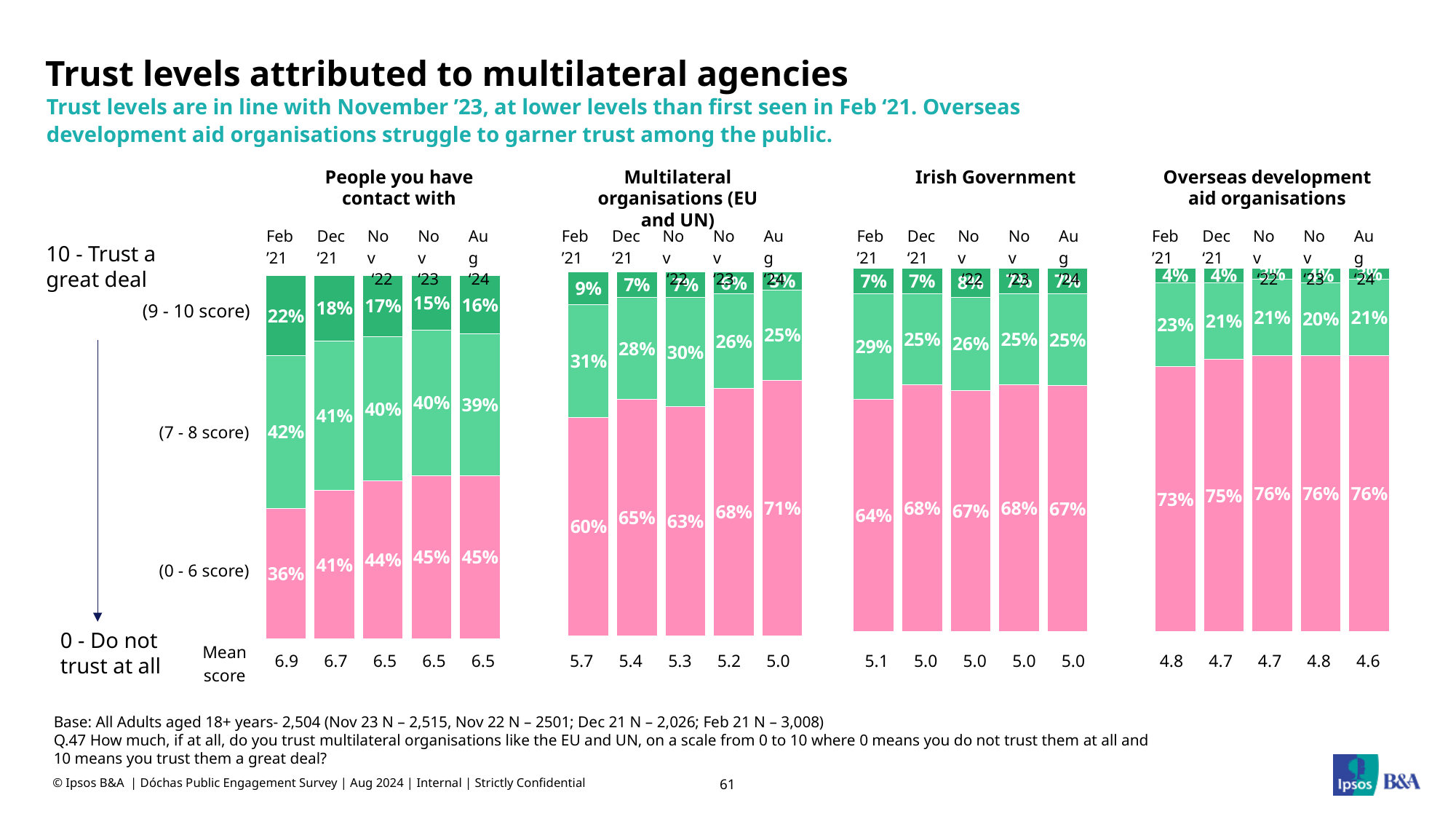
In the 'Overseas development aid organisations' chart, is the 0-6 score percentage larger in Feb '21 or in Dec '21? Dec '21 In the 'Overseas development aid organisations' chart, what is the mean score for Aug '24? 4.6 In the 'People you have contact with' chart, what percentage gave a 0-6 score in Feb '21? 36% In the 'People you have contact with' chart, which wave has the highest mean score? Feb '21 In the 'People you have contact with' chart, what is the difference between the 0-6 score percentage in Aug '24 and in Feb '21? 9 percentage points What type of chart is used on this slide? Stacked bar chart In the 'Multilateral organisations (EU and UN)' chart, what percentage gave a 9-10 score in Feb '21? 9% In the 'Multilateral organisations (EU and UN)' chart, what percentage gave a 0-6 score in Aug '24? 71% How many waves (bars) are shown in the 'Irish Government' chart? 5 In the 'Irish Government' chart, what percentage gave a 7-8 score in Feb '21? 29% In the 'Multilateral organisations (EU and UN)' chart, which wave has the lowest mean score? Aug '24 In the 'People you have contact with' chart, what is the mean score for Aug '24? 6.5